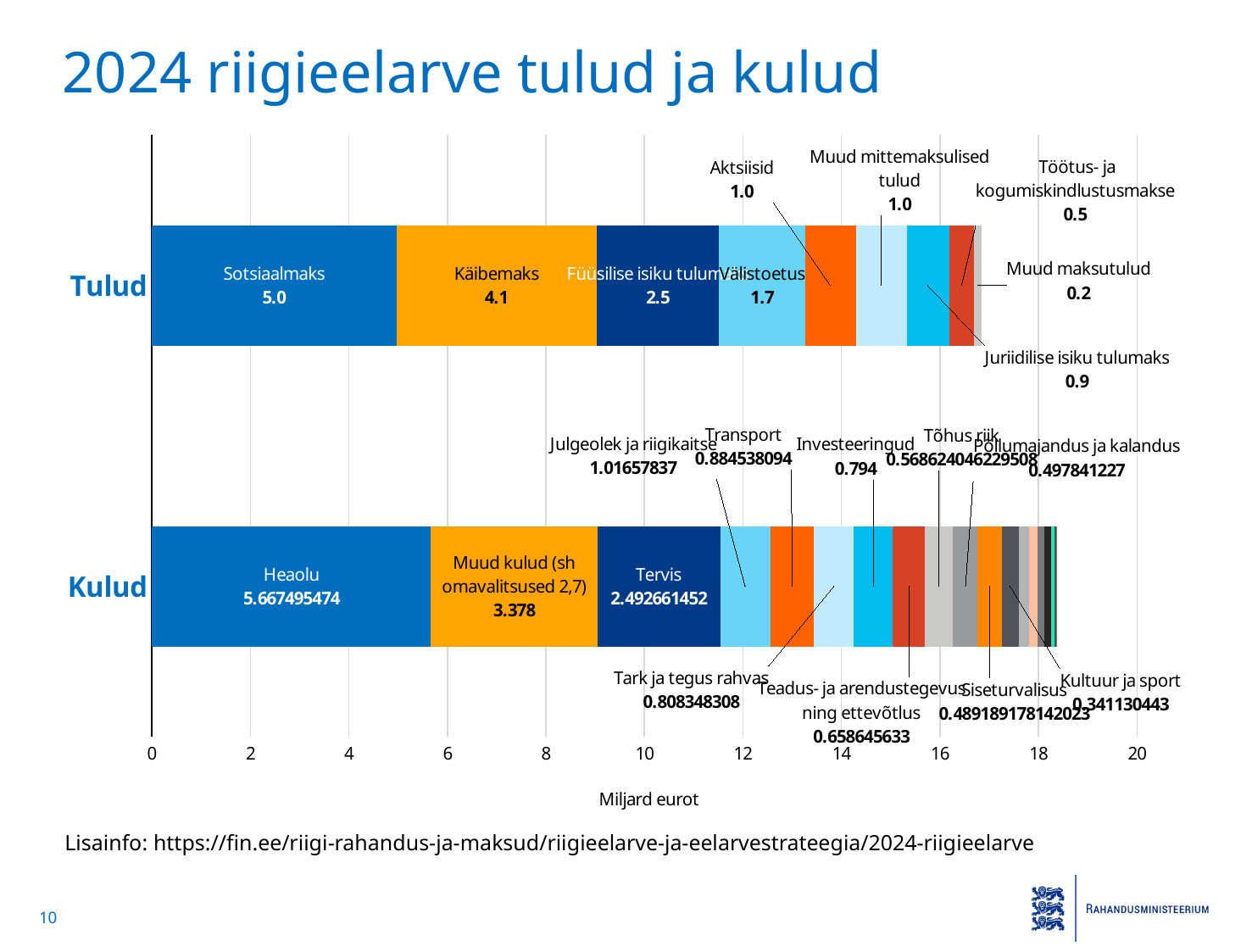
What is the value for Tervis in the Kulud bar? 2.492661452 Is the total length of the Kulud bar greater or less than 18? greater Which segment of the Tulud bar has the largest value? Sotsiaalmaks Which is larger: Heaolu in the Kulud bar or Sotsiaalmaks in the Tulud bar? Heaolu What unit is given on the x axis of the chart? Miljard eurot What is the value for Välistoetus in the Tulud bar? 1.7 What is the difference between Sotsiaalmaks and Käibemaks in the Tulud bar? 0.9 What type of chart is shown on the slide? bar chart What is the value for Heaolu in the Kulud bar? 5.667495474 What is the value for Sotsiaalmaks in the Tulud bar? 5.0 Which labelled segment of the Tulud bar has the smallest value? Muud maksutulud How many bars does the chart contain? 2